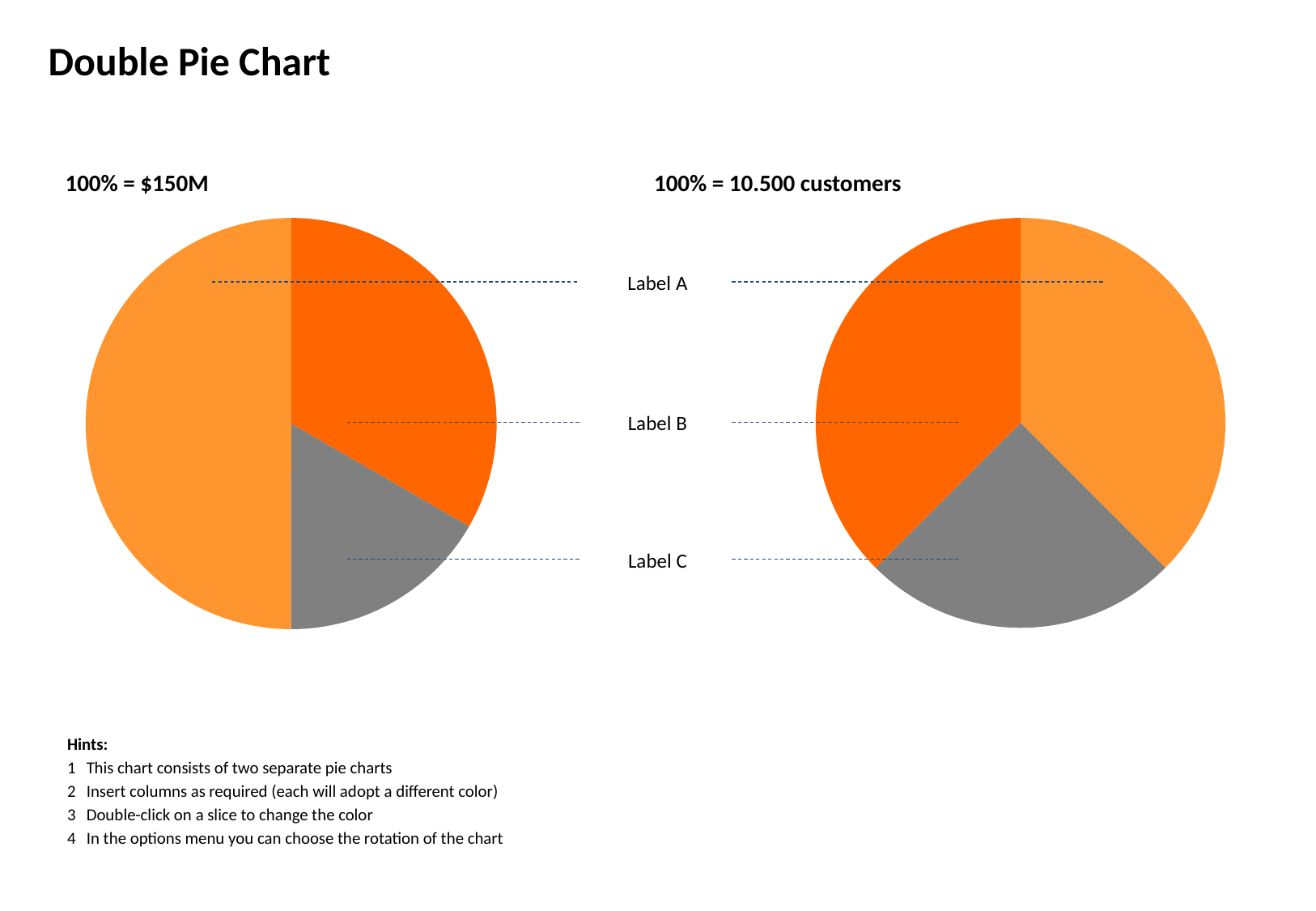
What total does 100% represent in the right pie chart? 10.500 customers What kind of chart is shown on the left side of the slide? Pie chart How many slices does the right pie chart (100% = 10.500 customers) have? 3 What total does 100% represent in the left pie chart? $150M In the left pie chart (100% = $150M), which slice is larger, Label B or Label C? Label B In the left pie chart (100% = $150M), which label has the largest slice? Label A What kind of chart is shown on the right side of the slide? Pie chart In the left pie chart (100% = $150M), which label has the smallest slice? Label C How many slices does the left pie chart (100% = $150M) have? 3 In the left pie chart (100% = $150M), which slice is larger, Label A or Label C? Label A